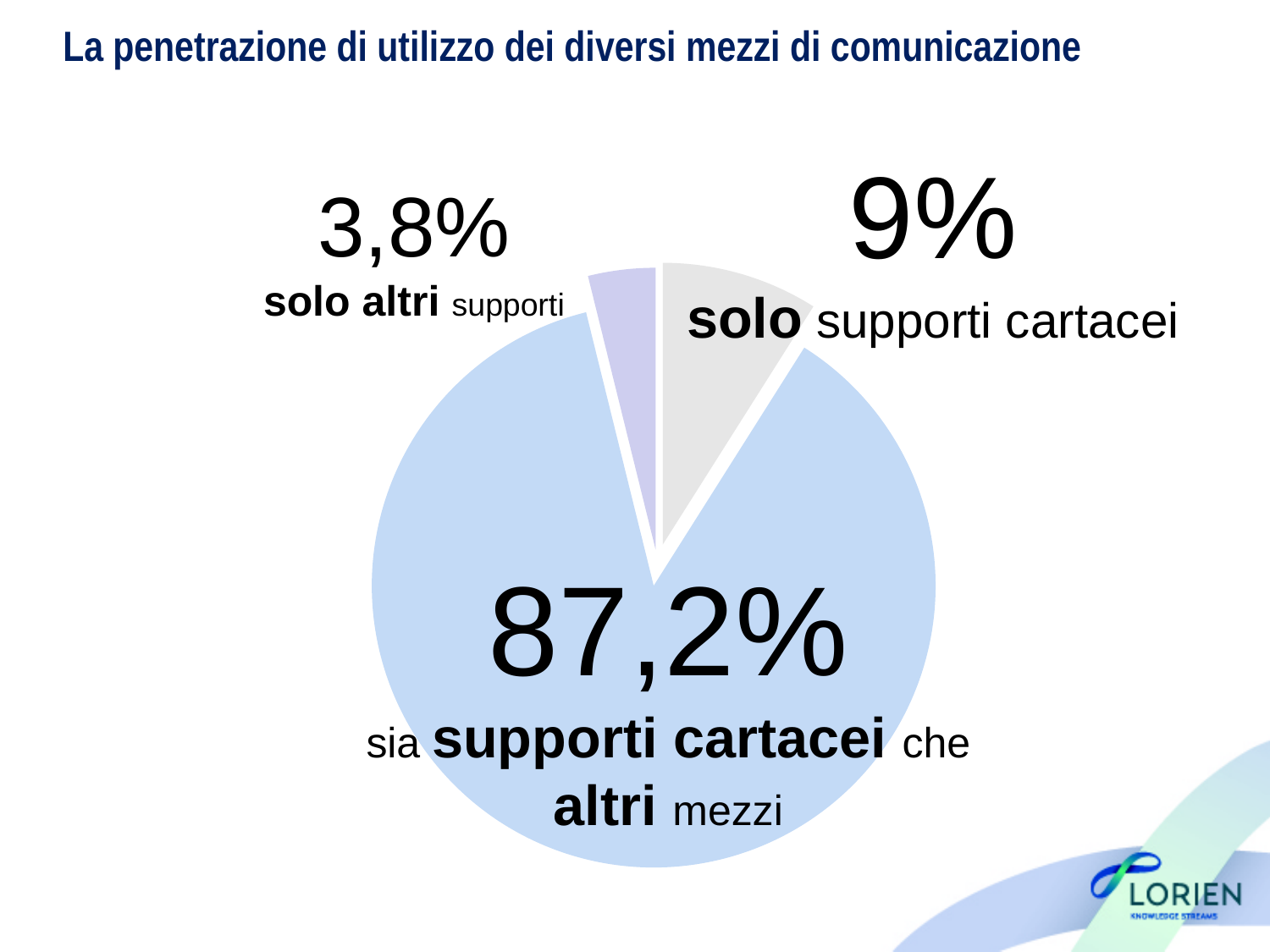
What is the difference between the 'solo supporti cartacei' share and the 'solo altri supporti' share? 5,2% What colour is the largest slice of the pie chart? light blue What share of the pie is labelled 'solo altri supporti'? 3,8% Which slice of the pie is the smallest? solo altri supporti What share of the pie is labelled 'sia supporti cartacei che altri mezzi'? 87,2% What share of the pie is labelled 'solo supporti cartacei'? 9% What is the title of the slide containing the pie chart? La penetrazione di utilizzo dei diversi mezzi di comunicazione What kind of chart is shown on the slide? pie chart What is the difference between the 'sia supporti cartacei che altri mezzi' share and the 'solo supporti cartacei' share? 78,2% Which is larger: the slice for 'solo supporti cartacei' or the slice for 'solo altri supporti'? solo supporti cartacei Which slice of the pie is the largest? sia supporti cartacei che altri mezzi How many slices does the pie chart have? 3